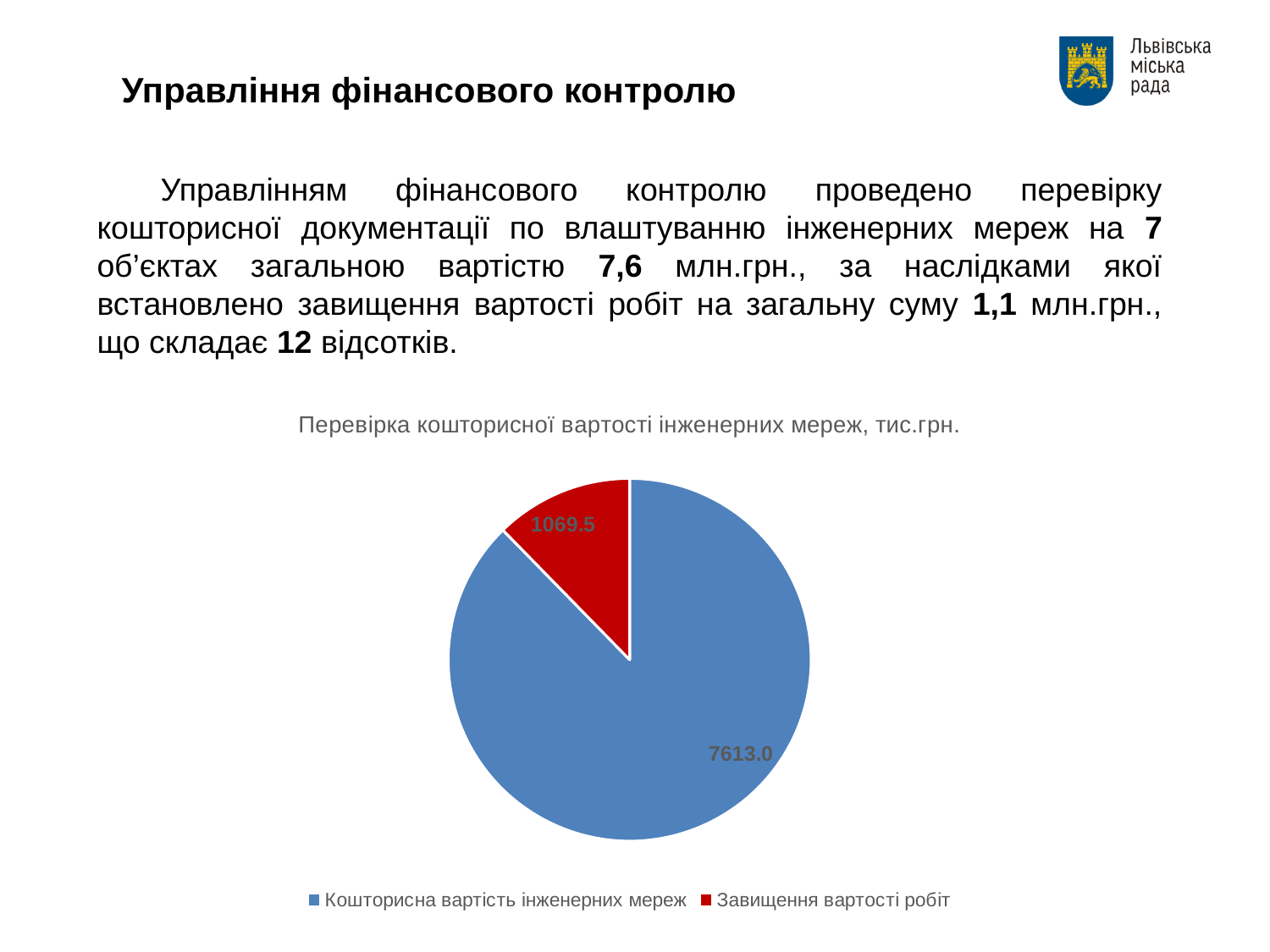
What is the title of the pie chart? Перевірка кошторисної вартості інженерних мереж, тис.грн. What is the value of the slice for Завищення вартості робіт? 1069.5 How many entries does the legend list? 2 What is the value of the slice for Кошторисна вартість інженерних мереж? 7613.0 How many slices does the pie chart have? 2 What colour is the slice for Завищення вартості робіт? red Which is larger: the value for Кошторисна вартість інженерних мереж or the value for Завищення вартості робіт? Кошторисна вартість інженерних мереж What kind of chart is shown on the slide? pie chart What is the total of the two slices in the pie chart? 8682.5 Which slice of the pie is the smallest? Завищення вартості робіт Which slice of the pie is the largest? Кошторисна вартість інженерних мереж What is the difference between the values for Кошторисна вартість інженерних мереж and Завищення вартості робіт? 6543.5